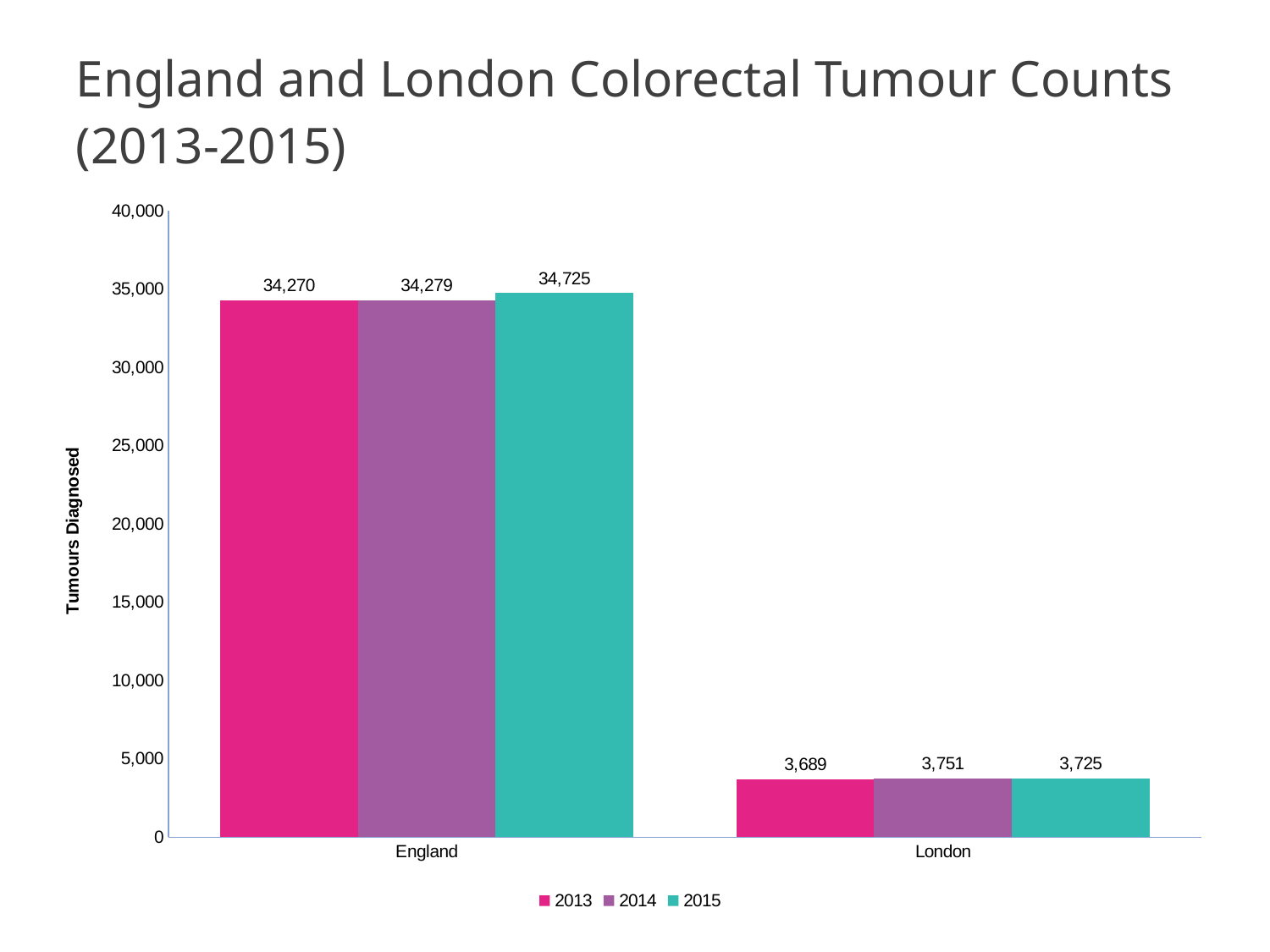
What is the number of tumours diagnosed in England in 2013? 34,270 Is the value for London in 2013 greater or less than 5,000? less What is the number of tumours diagnosed in London in 2015? 3,725 Which year had the highest tumour count for England? 2015 What is the difference between the London tumour counts in 2014 and 2013? 62 What is the number of tumours diagnosed in London in 2014? 3,751 Which year had the lowest tumour count for London? 2013 How many series does the legend list? 3 Which is larger: the London count in 2014 or the London count in 2015? 2014 What kind of chart is shown on the slide? bar chart What is the difference between the England tumour counts in 2015 and 2014? 446 What is the number of tumours diagnosed in England in 2015? 34,725